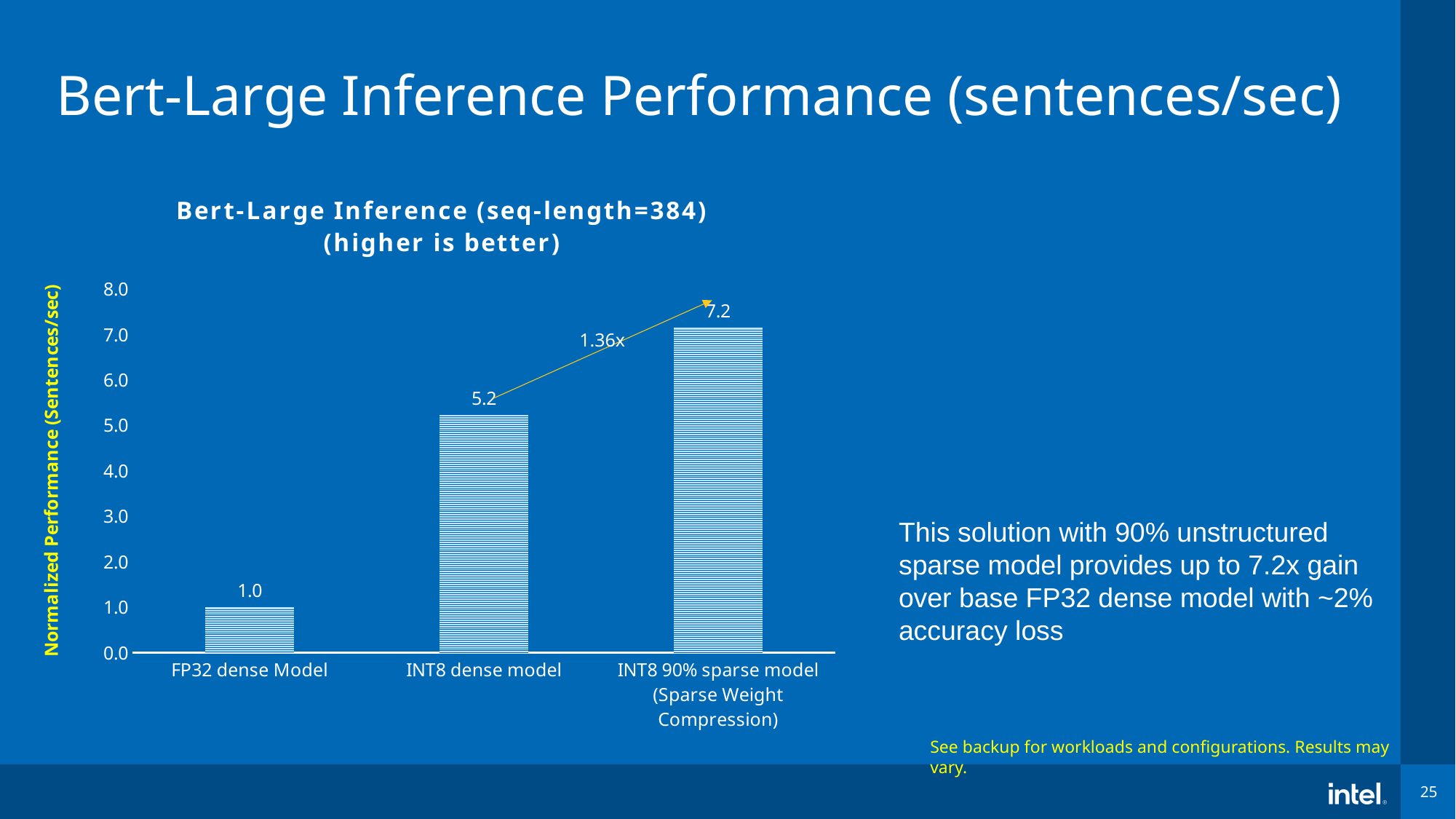
How many categories are shown on the x axis? 3 Do the values rise or fall from left to right along the x axis? rise What kind of chart is this? bar chart Which category has the highest value? INT8 90% sparse model (Sparse Weight Compression) What is the value for the FP32 dense Model? 1.0 What is the title of the chart? Bert-Large Inference (seq-length=384) (higher is better) What is the difference between the INT8 90% sparse model and the INT8 dense model? 2.0 What is the difference between the INT8 dense model and the FP32 dense Model? 4.2 Which category has the lowest value? FP32 dense Model Which is larger, the INT8 dense model or the FP32 dense Model? INT8 dense model What is the value for the INT8 dense model? 5.2 What is the value for the INT8 90% sparse model (Sparse Weight Compression)? 7.2